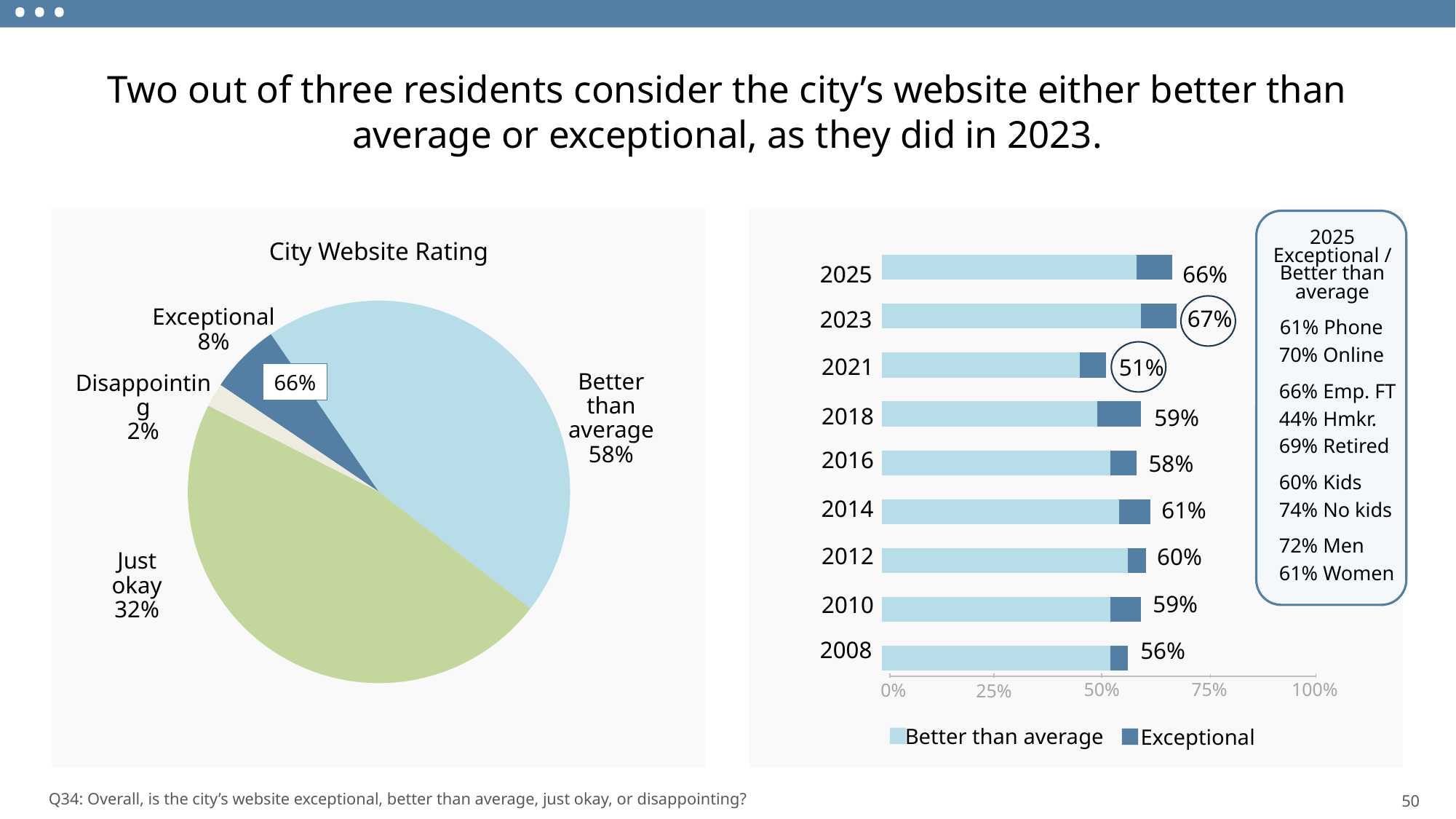
In the bar chart on the right, what is the combined percentage labeled for 2008? 56% In the bar chart on the right, what is the combined Exceptional / Better than average percentage for 2021? 51% In the City Website Rating pie chart, which category has the largest share? Better than average In the City Website Rating pie chart, what share of residents rated the website 'Just okay'? 32% In the City Website Rating pie chart, what share of residents rated the website 'Exceptional'? 8% In the bar chart on the right, which year has the lowest combined percentage? 2021 In the City Website Rating pie chart, what is the difference between the 'Better than average' share and the 'Just okay' share? 26 percentage points In the bar chart on the right, which year has the highest combined percentage? 2023 In the bar chart on the right, how many years are shown? 9 In the City Website Rating pie chart, which category has the smallest share? Disappointing In the bar chart on the right, how many series does the legend list? 2 What type of chart is the chart on the right side of the slide? Bar chart